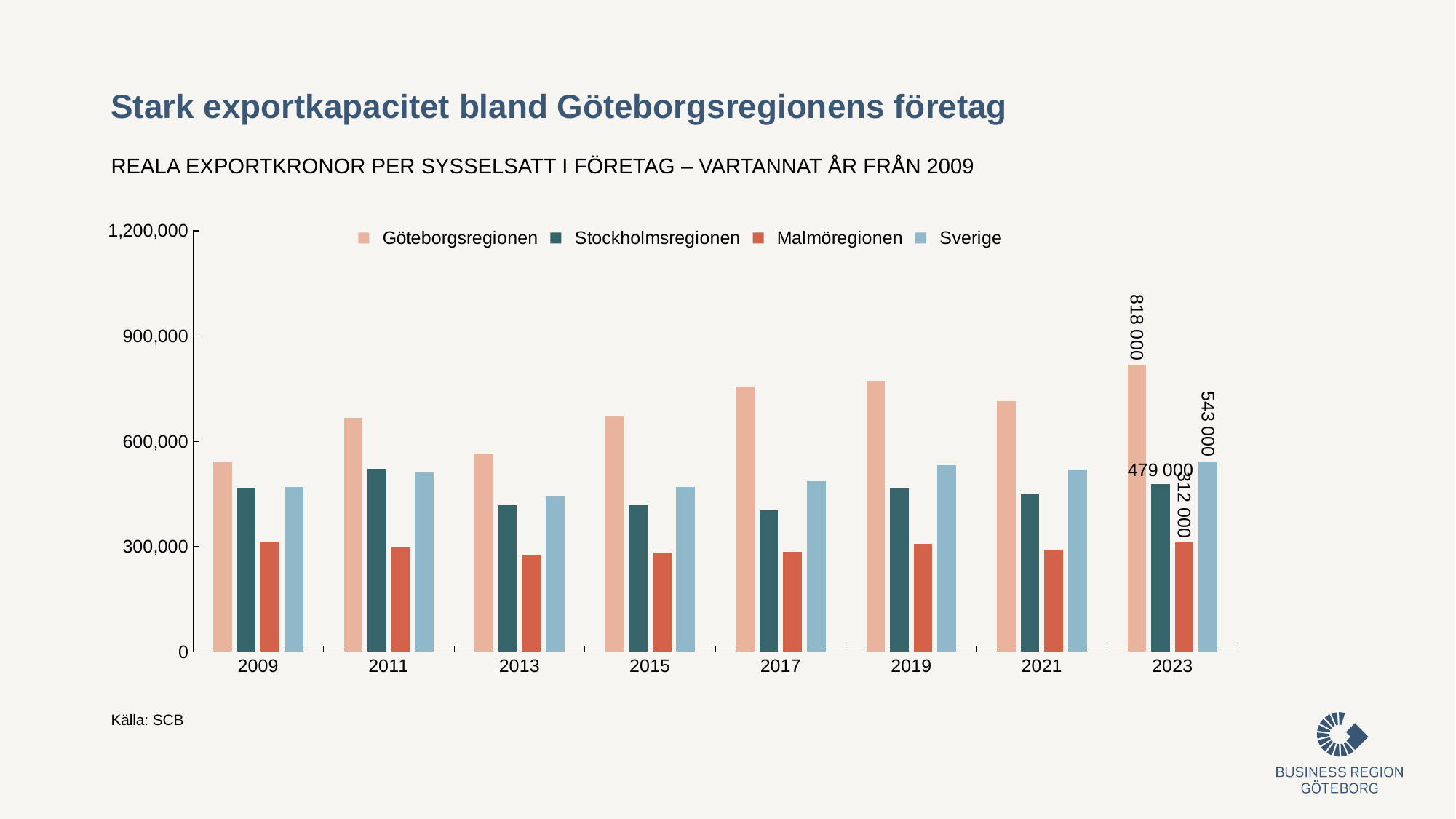
Which series has the highest value in 2023? Göteborgsregionen What is the value for Stockholmsregionen in 2023? 479 000 What kind of chart is shown on the slide? bar chart What is the value for Sverige in 2023? 543 000 How many series does the legend list? 4 What is the difference between Göteborgsregionen and Sverige in 2023? 275 000 What is the value for Göteborgsregionen in 2023? 818 000 What is the value for Malmöregionen in 2023? 312 000 How many years are shown on the x axis? 8 Which series has the lowest value in 2023? Malmöregionen Which is larger in 2023, Stockholmsregionen or Sverige? Sverige Is the value for Malmöregionen in 2013 greater or less than 300,000? less